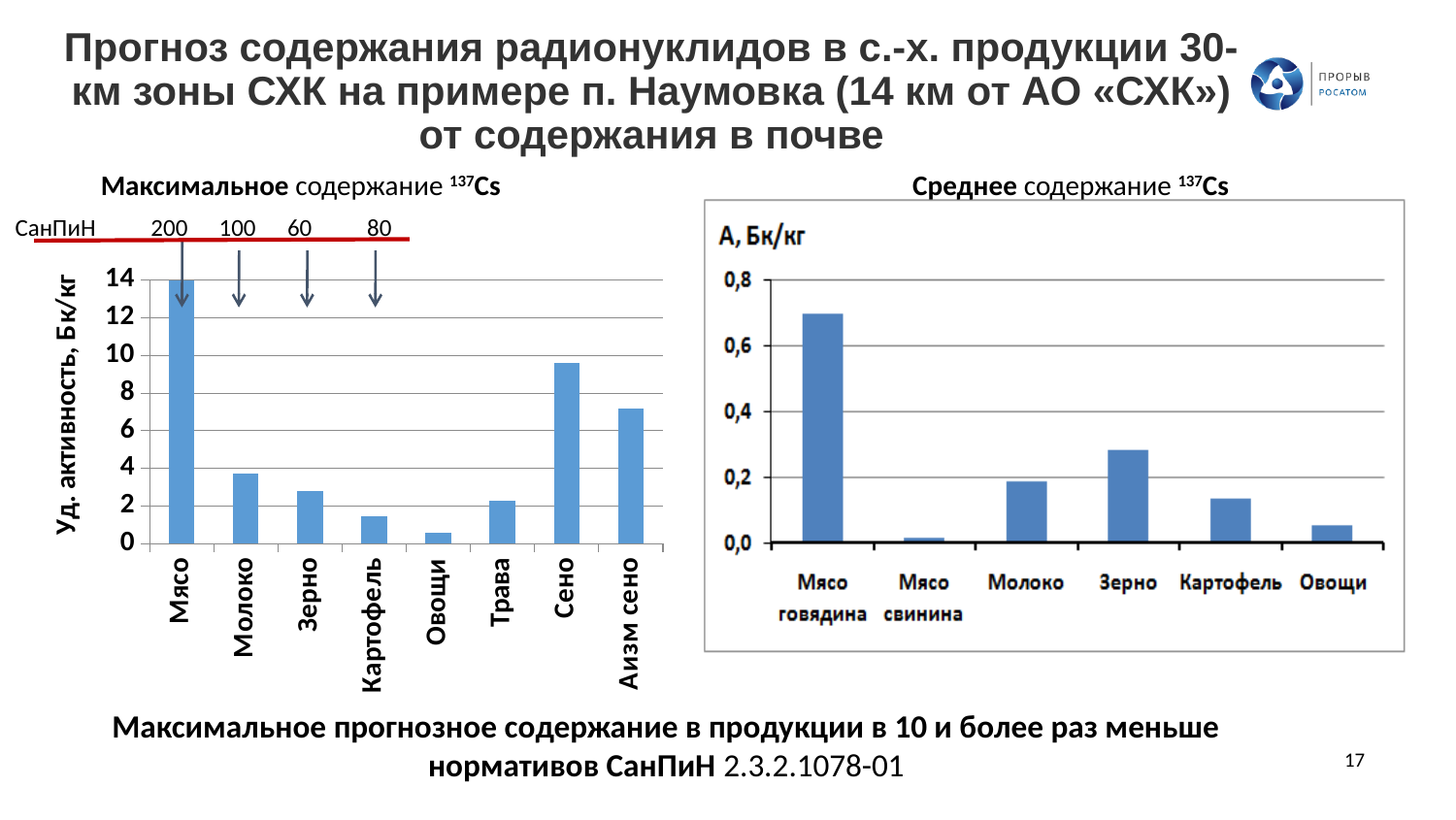
On the left chart 'Максимальное содержание 137Cs', is the value for Сено greater or less than 8? greater On the right chart 'Среднее содержание 137Cs', which category has the highest value? Мясо говядина On the right chart 'Среднее содержание 137Cs', which category has the lowest value? Мясо свинина On the left chart 'Максимальное содержание 137Cs', which is larger: the value for Сено or the value for Аизм сено? Сено What kind of chart is the left chart titled 'Максимальное содержание 137Cs'? bar chart On the left chart 'Максимальное содержание 137Cs', is the value for Молоко greater or less than 4? less On the right chart 'Среднее содержание 137Cs', is the value for Зерно greater or less than 0,2? greater On the left chart 'Максимальное содержание 137Cs', which category has the highest value? Мясо On the left chart 'Максимальное содержание 137Cs', which category has the lowest value? Овощи How many categories are shown on the right chart 'Среднее содержание 137Cs'? 6 What is the y-axis label on the left chart 'Максимальное содержание 137Cs'? Уд. активность, Бк/кг How many categories are shown on the left chart 'Максимальное содержание 137Cs'? 8